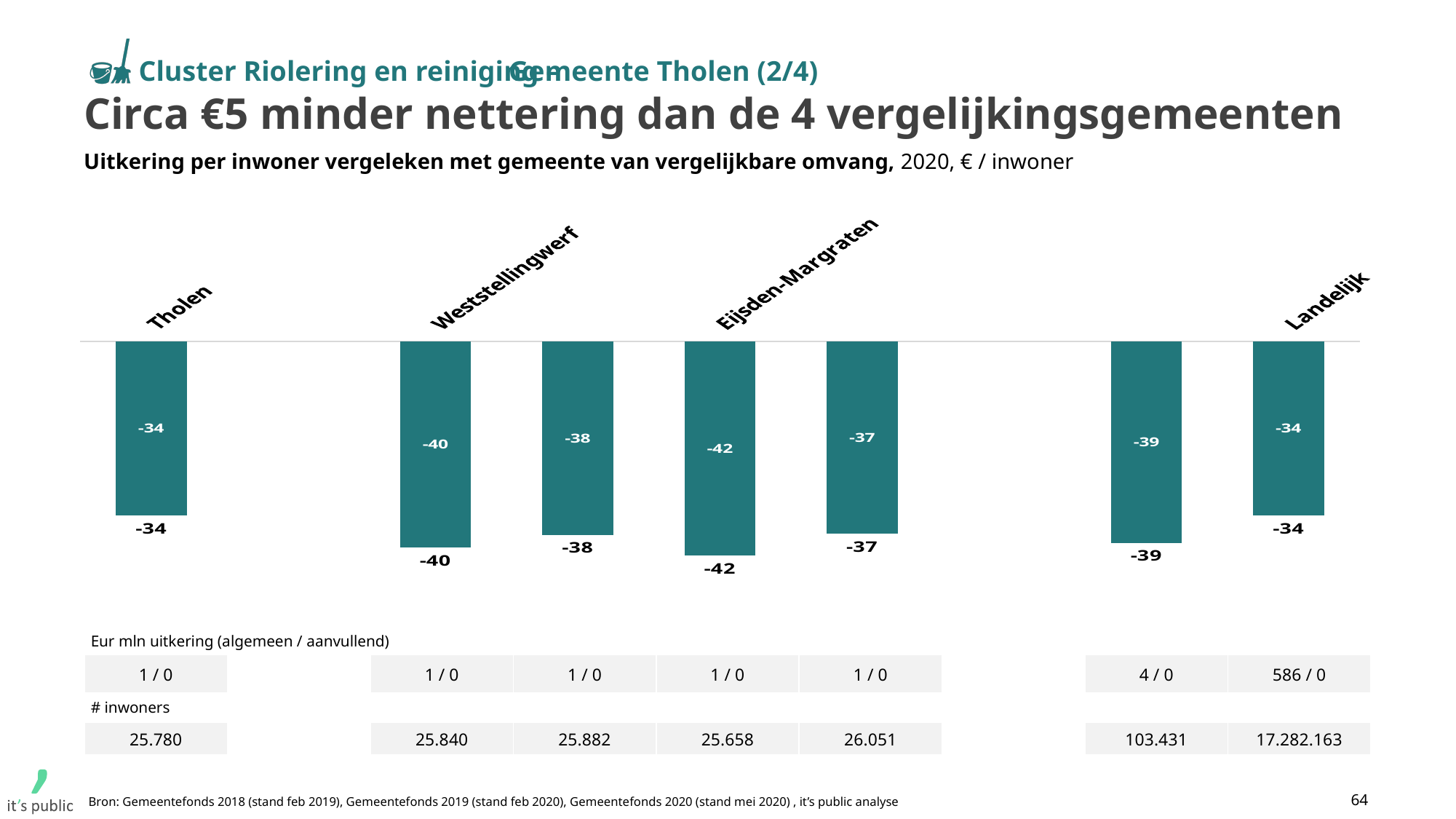
What is the value for Weststellingwerf? -40 How many bars are plotted in the chart? 7 What is the difference between the values for Tholen and Eijsden-Margraten? 8 Which has the higher value, Tholen or Weststellingwerf? Tholen What kind of chart is shown on the slide? Bar chart In what unit are the chart values expressed, according to the subtitle? € / inwoner Which has the higher value, Eijsden-Margraten or Landelijk? Landelijk What is the value for Tholen? -34 Which labelled category has the lowest value? Eijsden-Margraten What is the value for Landelijk? -34 What is the value for Eijsden-Margraten? -42 What is the difference between the values for Tholen and Weststellingwerf? 6